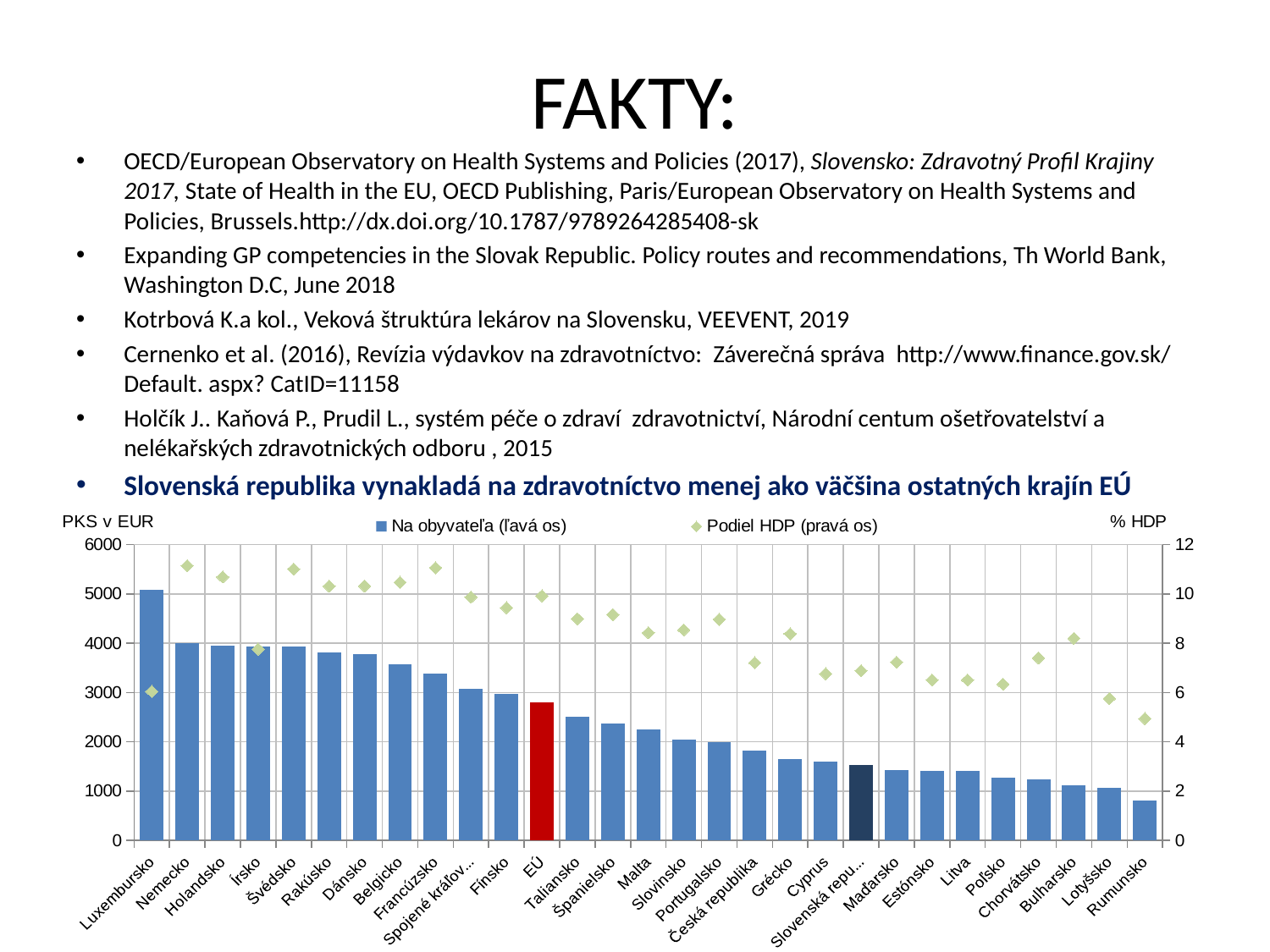
Which category's bar is coloured red in the chart? EÚ How many series does the chart legend list? 2 Which has the larger 'Na obyvateľa' bar, Nemecko or Taliansko? Nemecko Is the 'Na obyvateľa' value for Rumunsko greater or less than 1000? less Which category has the lowest bar for 'Na obyvateľa (ľavá os)'? Rumunsko Is the 'Na obyvateľa' value for EÚ greater or less than 3000? less Is the 'Podiel HDP (pravá os)' value for Luxembursko greater or less than 8? less Do the 'Na obyvateľa' bars rise or fall from left to right along the x axis? fall Which category has the highest bar for 'Na obyvateľa (ľavá os)'? Luxembursko How many countries/categories are shown on the x axis of the chart? 29 What kind of chart is shown on the slide? bar chart